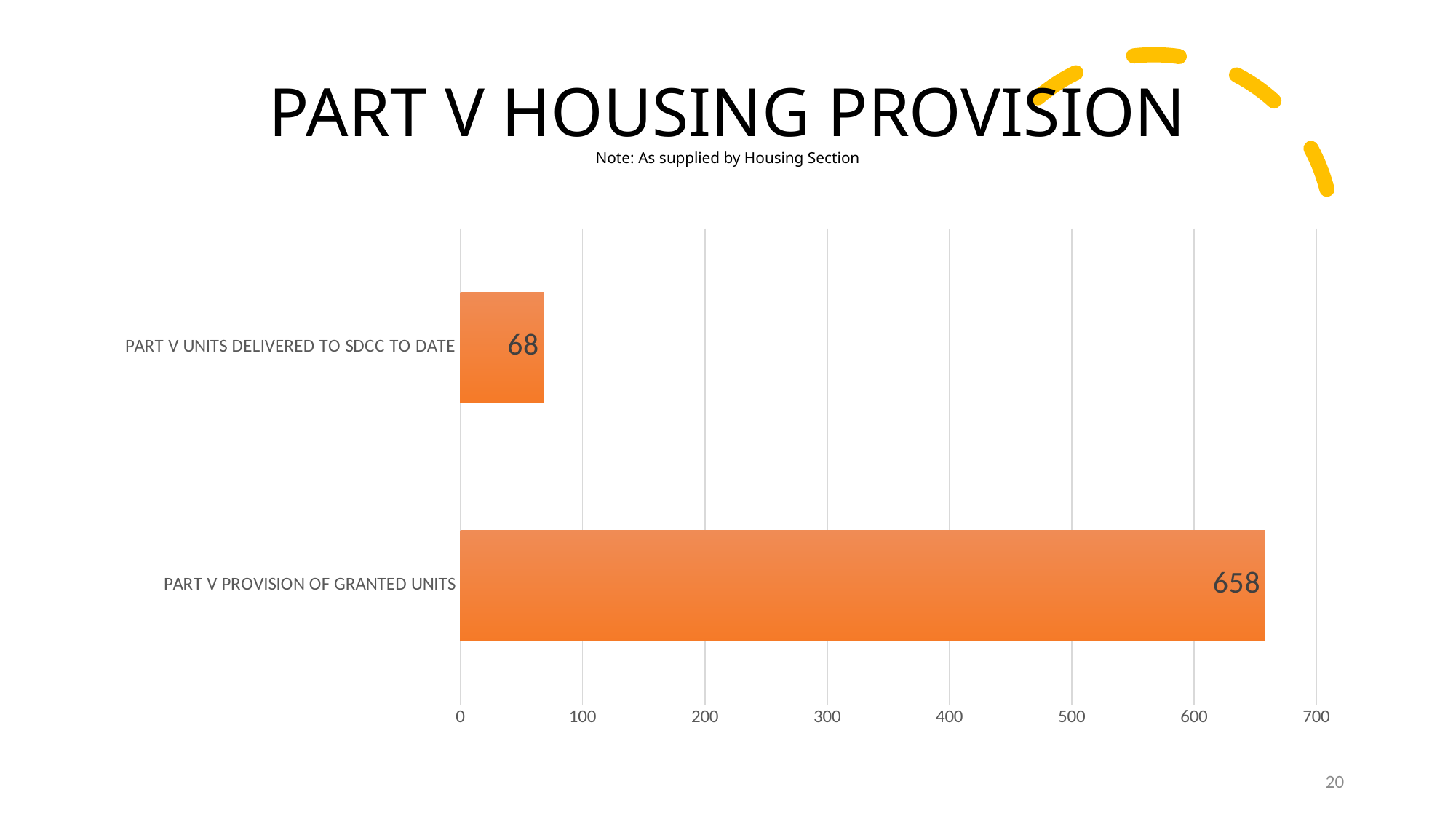
What is the difference between PART V PROVISION OF GRANTED UNITS and PART V UNITS DELIVERED TO SDCC TO DATE? 590 Which is larger: PART V UNITS DELIVERED TO SDCC TO DATE or PART V PROVISION OF GRANTED UNITS? PART V PROVISION OF GRANTED UNITS What is the value for PART V UNITS DELIVERED TO SDCC TO DATE? 68 Is the value for PART V PROVISION OF GRANTED UNITS greater or less than 600? greater Is the value for PART V UNITS DELIVERED TO SDCC TO DATE greater or less than 100? less What is the maximum value shown on the horizontal axis? 700 What kind of chart is shown on the slide? bar chart Which category has the highest value? PART V PROVISION OF GRANTED UNITS What is the value for PART V PROVISION OF GRANTED UNITS? 658 Which category has the lowest value? PART V UNITS DELIVERED TO SDCC TO DATE What is the title of the slide containing the chart? PART V HOUSING PROVISION How many categories are shown in the chart? 2